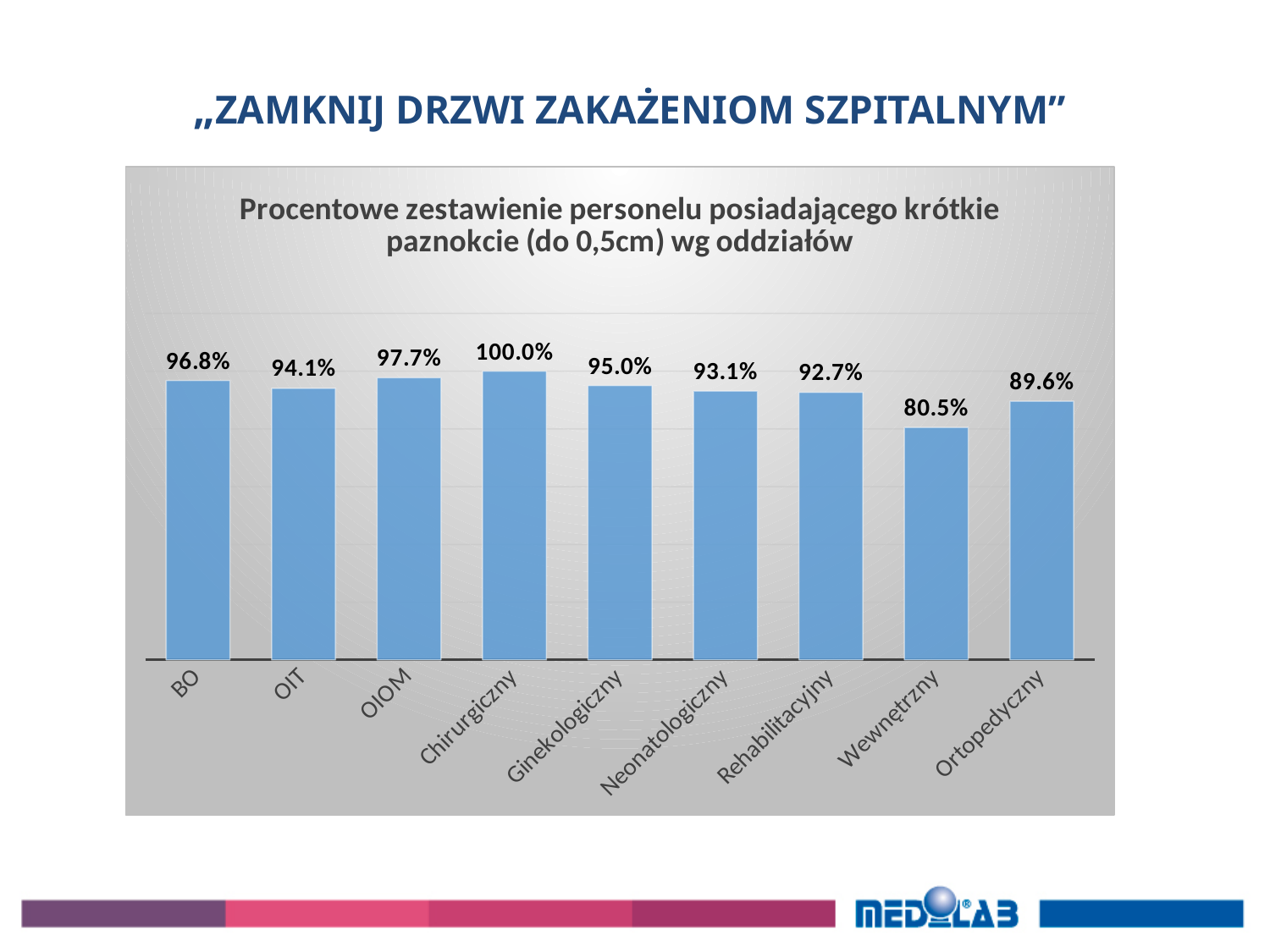
What is the value for Chirurgiczny? 100.0% Which department has the highest value? Chirurgiczny What is the value for OIOM? 97.7% What is the value for Wewnętrzny? 80.5% How many departments are shown on the chart? 9 What is the value for Ortopedyczny? 89.6% What is the title of the chart? Procentowe zestawienie personelu posiadającego krótkie paznokcie (do 0,5cm) wg oddziałów What is the difference between the values for Chirurgiczny and Wewnętrzny? 19.5% What is the difference between the values for BO and OIT? 2.7% What kind of chart is shown on the slide? Bar chart Which is larger, the value for Ginekologiczny or the value for Rehabilitacyjny? Ginekologiczny Which department has the lowest value? Wewnętrzny